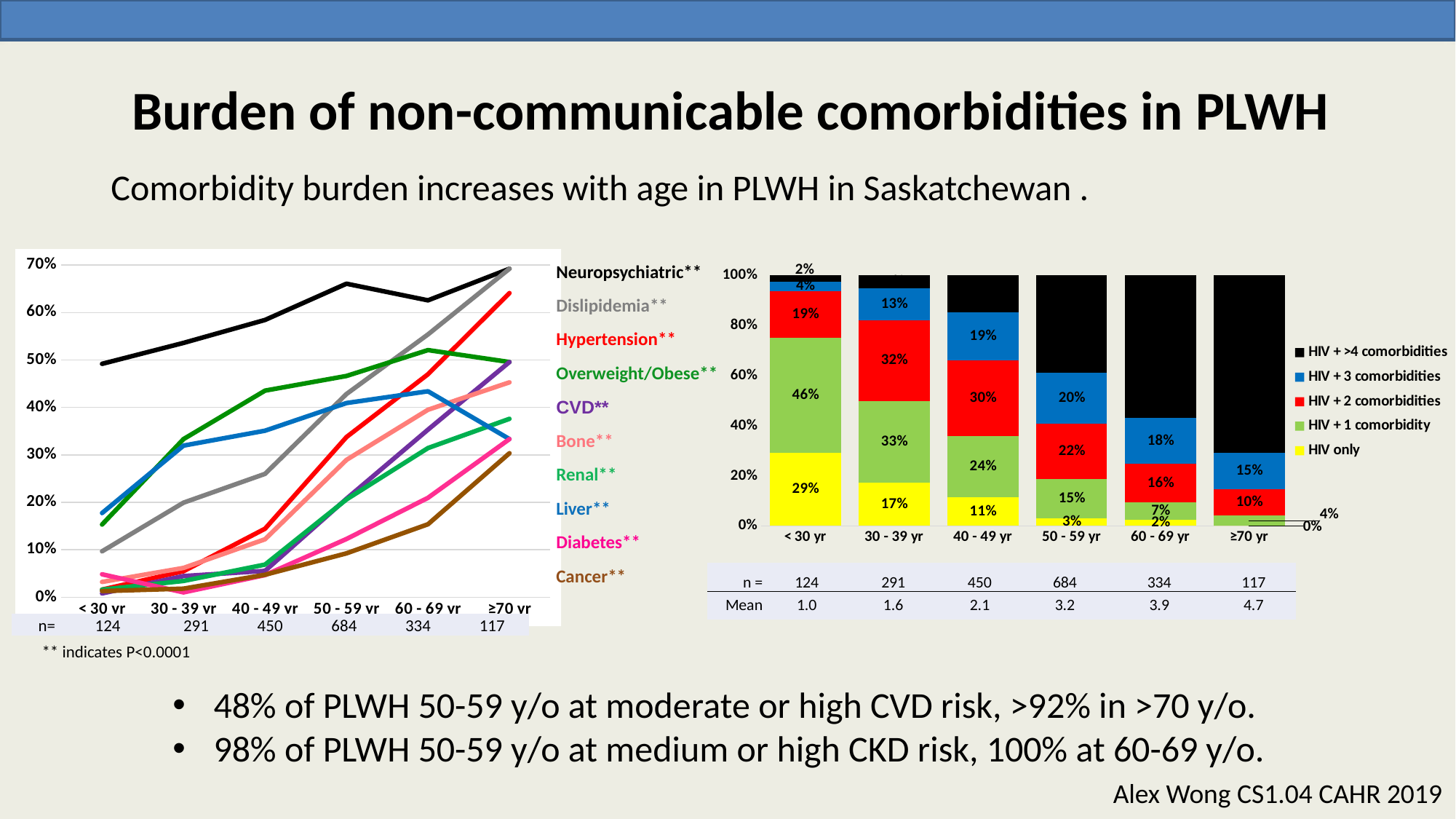
In the stacked bar chart on the right, is the 'HIV + 2 comorbidities' value larger for the 30 - 39 yr group or the 50 - 59 yr group? 30 - 39 yr What kind of chart is the chart on the left of the slide? Line chart In the stacked bar chart on the right, which age group has the highest 'HIV only' share? < 30 yr In the stacked bar chart on the right, what is the value for 'HIV + 2 comorbidities' in the 40 - 49 yr group? 30% In the line chart on the left, is the Neuropsychiatric value for the 50 - 59 yr group greater or less than 60%? greater In the stacked bar chart on the right, what is the difference in the 'HIV + 1 comorbidity' value between the < 30 yr and 30 - 39 yr groups? 13 percentage points In the line chart on the left, does the Dislipidemia line rise or fall as age increases? Rises How many age groups are shown on the x axis of the stacked bar chart on the right? 6 How many comorbidity series are plotted in the line chart on the left? 10 In the stacked bar chart on the right, what is the value for 'HIV + 3 comorbidities' in the ≥70 yr group? 15% How many series does the legend of the stacked bar chart on the right list? 5 In the stacked bar chart on the right, what percentage of the < 30 yr group is 'HIV only'? 29%